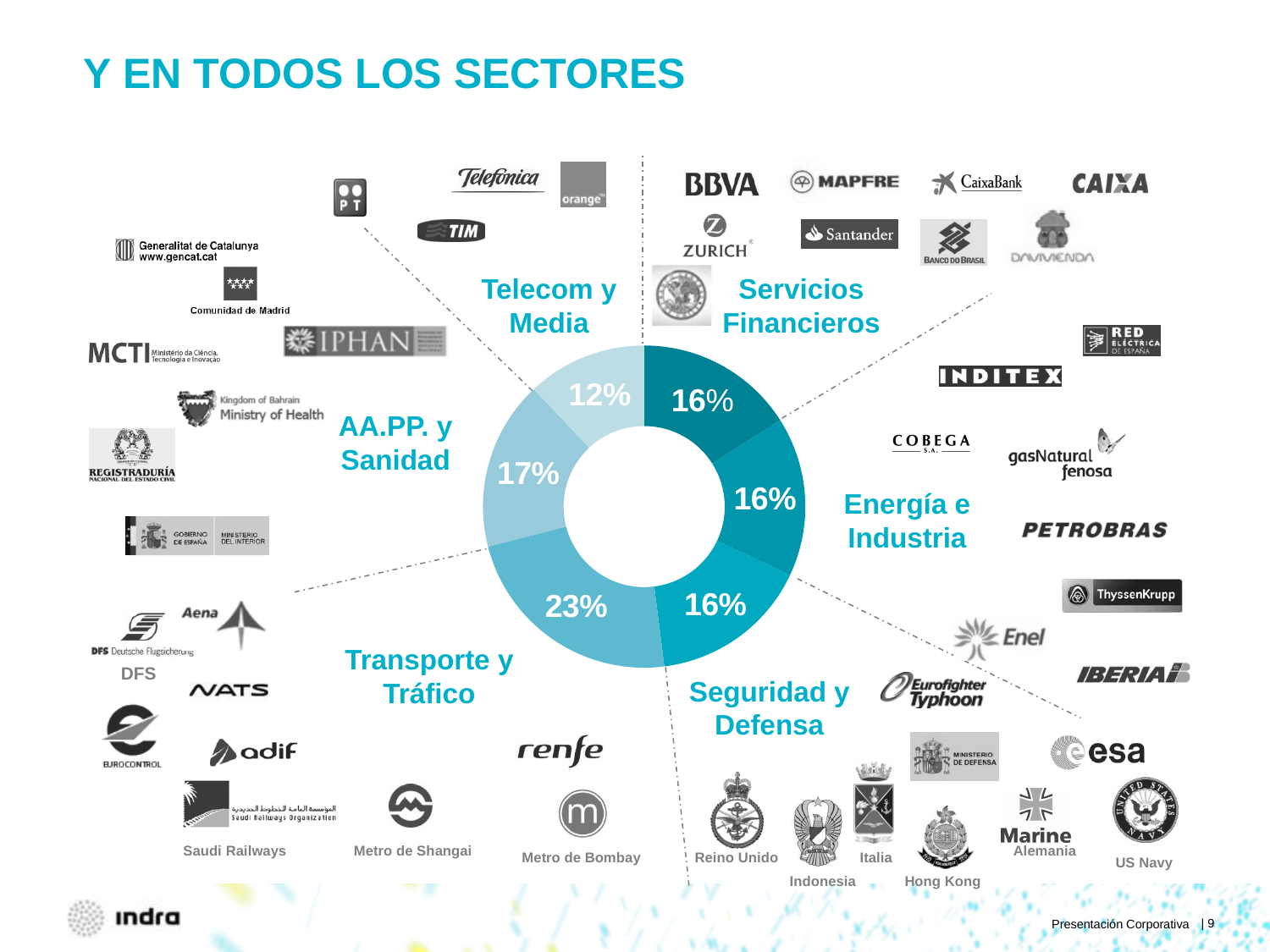
How many sectors in the donut chart have a share of exactly 16%? 3 Which has a larger share, AA.PP. y Sanidad or Seguridad y Defensa? AA.PP. y Sanidad Which sector has the largest share in the donut chart? Transporte y Tráfico How many sectors are shown in the donut chart? 6 What type of chart is used on the slide? Donut (pie) chart Which sector has the smallest share in the donut chart? Telecom y Media What is the difference in percentage points between Transporte y Tráfico and Telecom y Media? 11 What share of the donut chart corresponds to Transporte y Tráfico? 23% What is the difference in percentage points between AA.PP. y Sanidad and Energía e Industria? 1 What percentage is shown for Servicios Financieros in the donut chart? 16% What percentage is shown for Telecom y Media in the donut chart? 12% What percentage does the donut chart show for AA.PP. y Sanidad? 17%